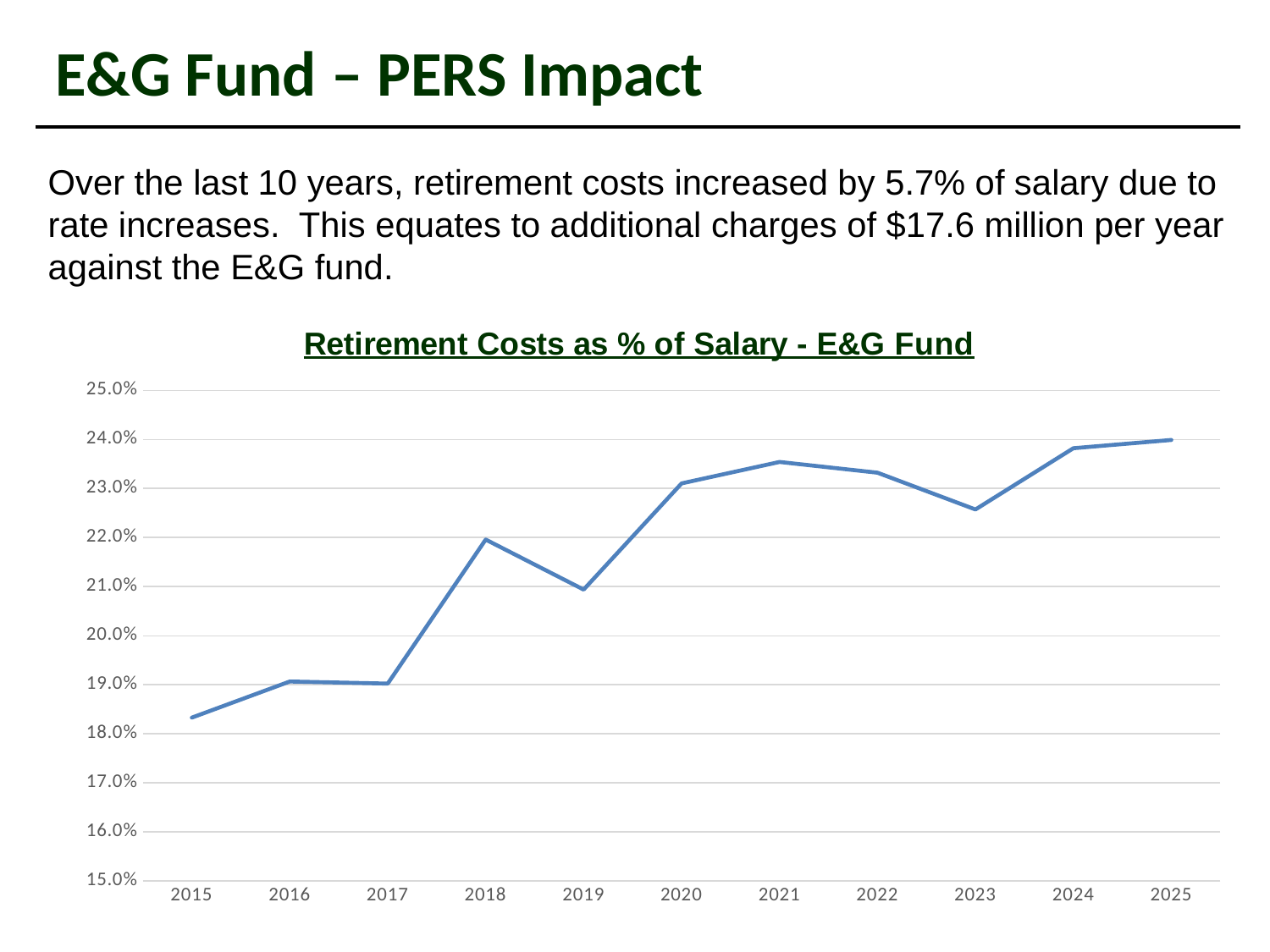
Is the value for 2021 greater or less than 23.0%? greater Overall, do retirement costs as a percentage of salary rise or fall from 2015 to 2025? rise Which year has the higher value, 2018 or 2019? 2018 Is the value for 2016 greater or less than 20.0%? less How many years are plotted on the x axis of the chart? 11 What is the title of the chart? Retirement Costs as % of Salary - E&G Fund Is the value for 2018 greater or less than 21.0%? greater What kind of chart is shown on the slide? line chart Which year has the higher value, 2017 or 2020? 2020 Which year has the lowest retirement cost as a percentage of salary? 2015